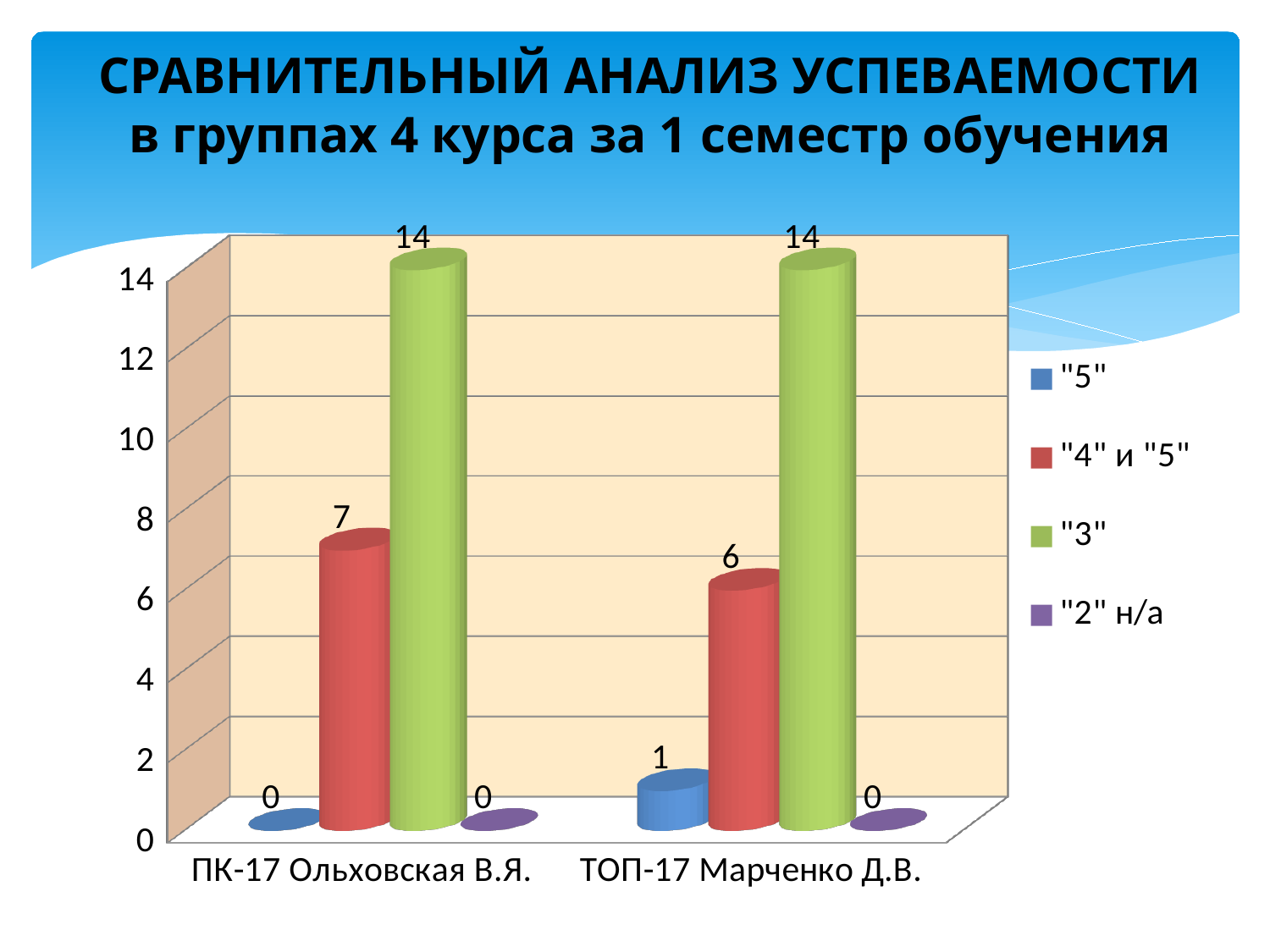
How many series does the legend list? 4 What kind of chart is shown on the slide? Bar chart Which series has the highest value in the ПК-17 Ольховская В.Я. group? "3" What is the value for "3" in the ПК-17 Ольховская В.Я. group? 14 Which group has the larger value for "4" и "5": ПК-17 Ольховская В.Я. or ТОП-17 Марченко Д.В.? ПК-17 Ольховская В.Я. Which colour represents the "3" series in the legend? Green What is the value for "5" in the ТОП-17 Марченко Д.В. group? 1 What is the value for "2" н/а in the ПК-17 Ольховская В.Я. group? 0 What is the total of all four series for the ТОП-17 Марченко Д.В. group? 21 What is the value for "4" и "5" in the ТОП-17 Марченко Д.В. group? 6 What is the difference between the "4" и "5" values for ПК-17 Ольховская В.Я. and ТОП-17 Марченко Д.В.? 1 How many groups (categories) are shown on the x axis? 2